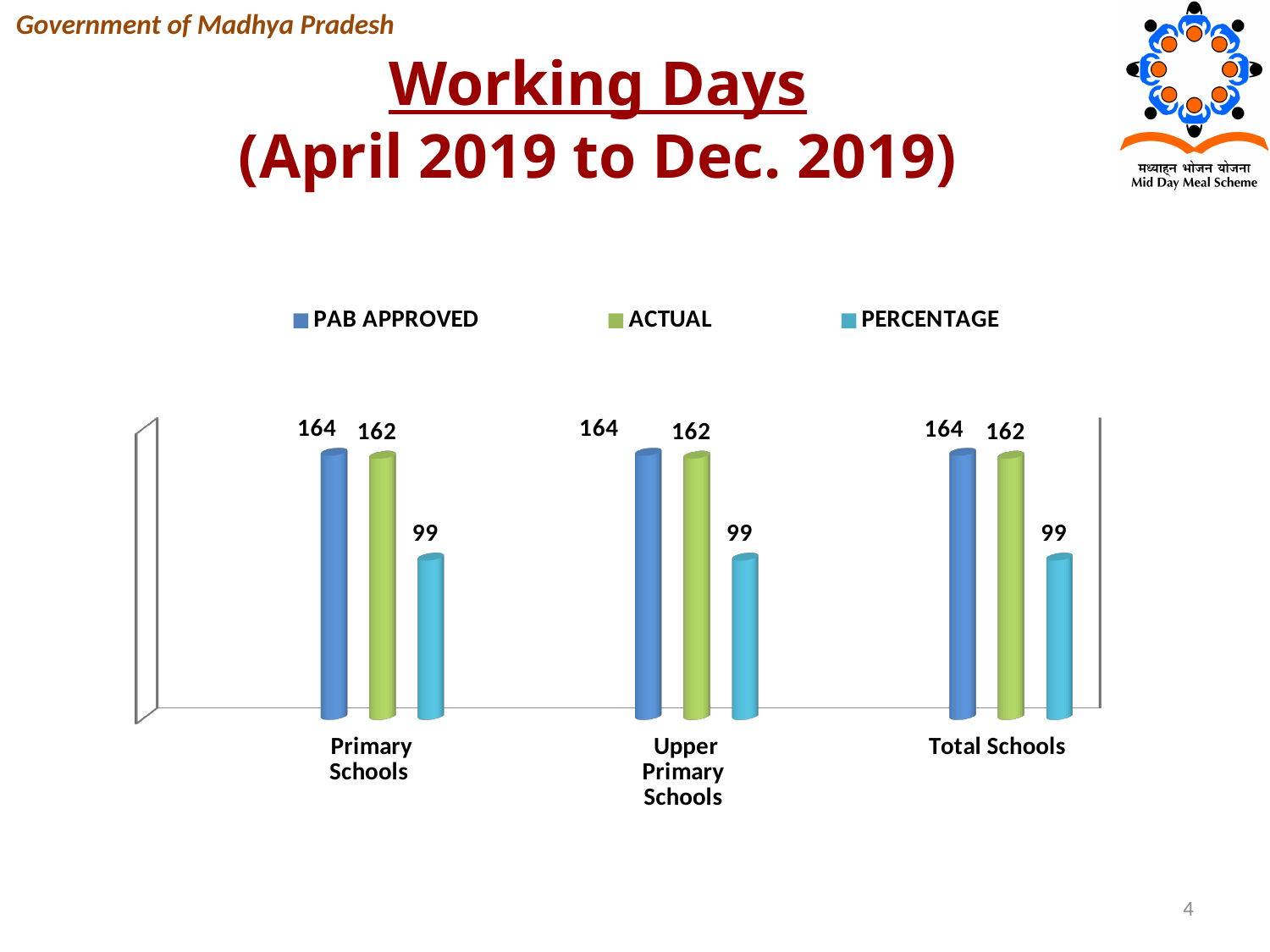
What is the difference between the PAB APPROVED and ACTUAL values for Primary Schools? 2 Which is larger for Upper Primary Schools, the PAB APPROVED value or the PERCENTAGE value? PAB APPROVED What is the difference between the ACTUAL and PERCENTAGE values for Total Schools? 63 What is the PERCENTAGE value for Total Schools? 99 How many series does the legend list? 3 How many categories are shown on the x axis? 3 What is the ACTUAL value for Total Schools? 162 What is the ACTUAL value for Upper Primary Schools? 162 What kind of chart is shown on the slide? Bar chart Which series has the highest value for Upper Primary Schools? PAB APPROVED Which series has the lowest value for Primary Schools? PERCENTAGE What is the PAB APPROVED value for Primary Schools? 164